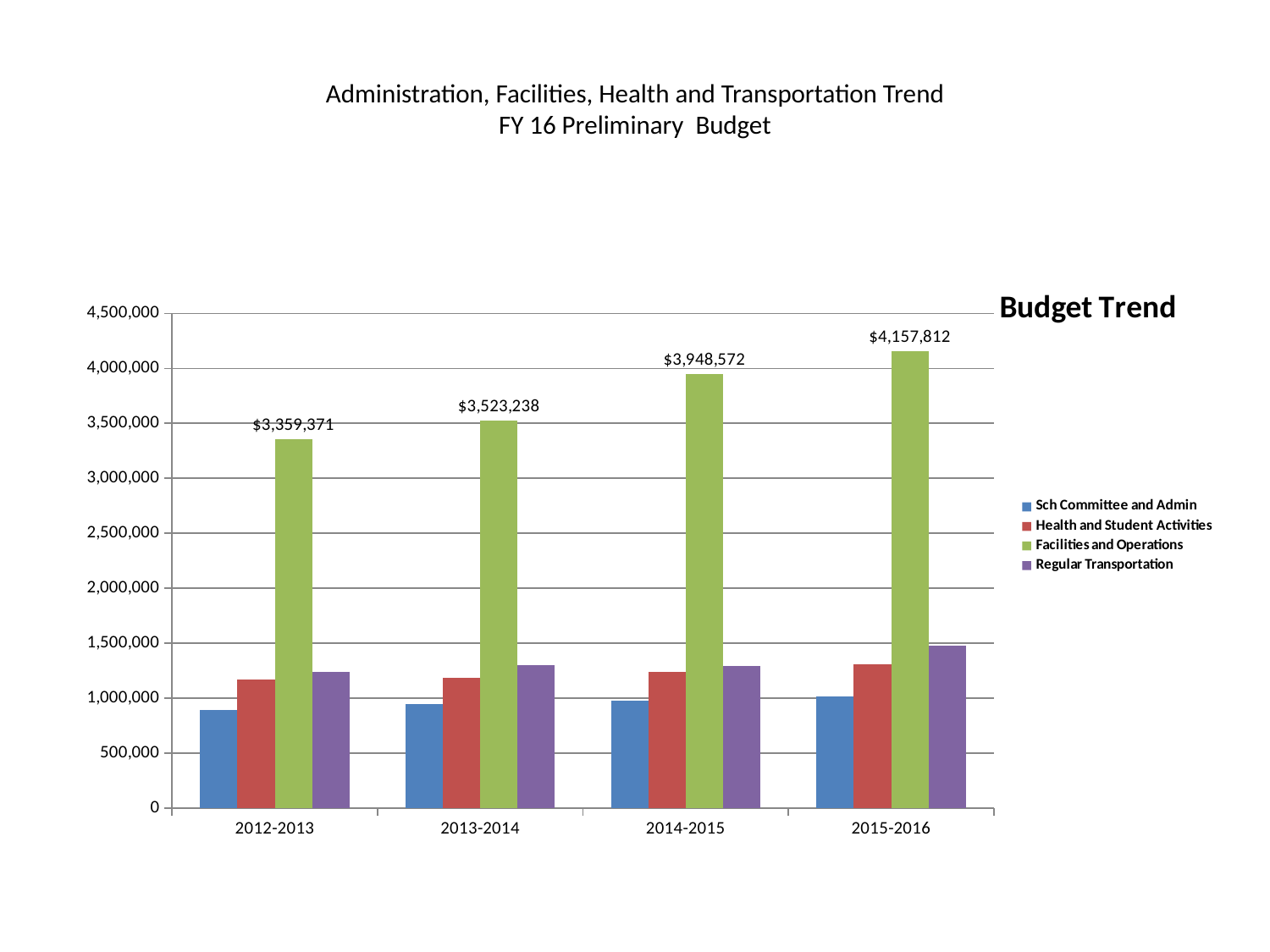
What kind of chart is shown on the slide? bar chart In 2015-2016, which is larger: Regular Transportation or Health and Student Activities? Regular Transportation What is the difference between the Facilities and Operations values for 2015-2016 and 2012-2013? $798,441 In which year is the Facilities and Operations value lowest? 2012-2013 Do the Facilities and Operations values rise or fall from 2012-2013 to 2015-2016? rise Is the value for Sch Committee and Admin in 2012-2013 greater or less than 1,000,000? less How many series does the legend list? 4 How many year categories are shown on the x axis? 4 What is the value for Facilities and Operations in 2015-2016? $4,157,812 What is the value for Facilities and Operations in 2014-2015? $3,948,572 What is the value for Facilities and Operations in 2012-2013? $3,359,371 In which year is the Facilities and Operations value highest? 2015-2016